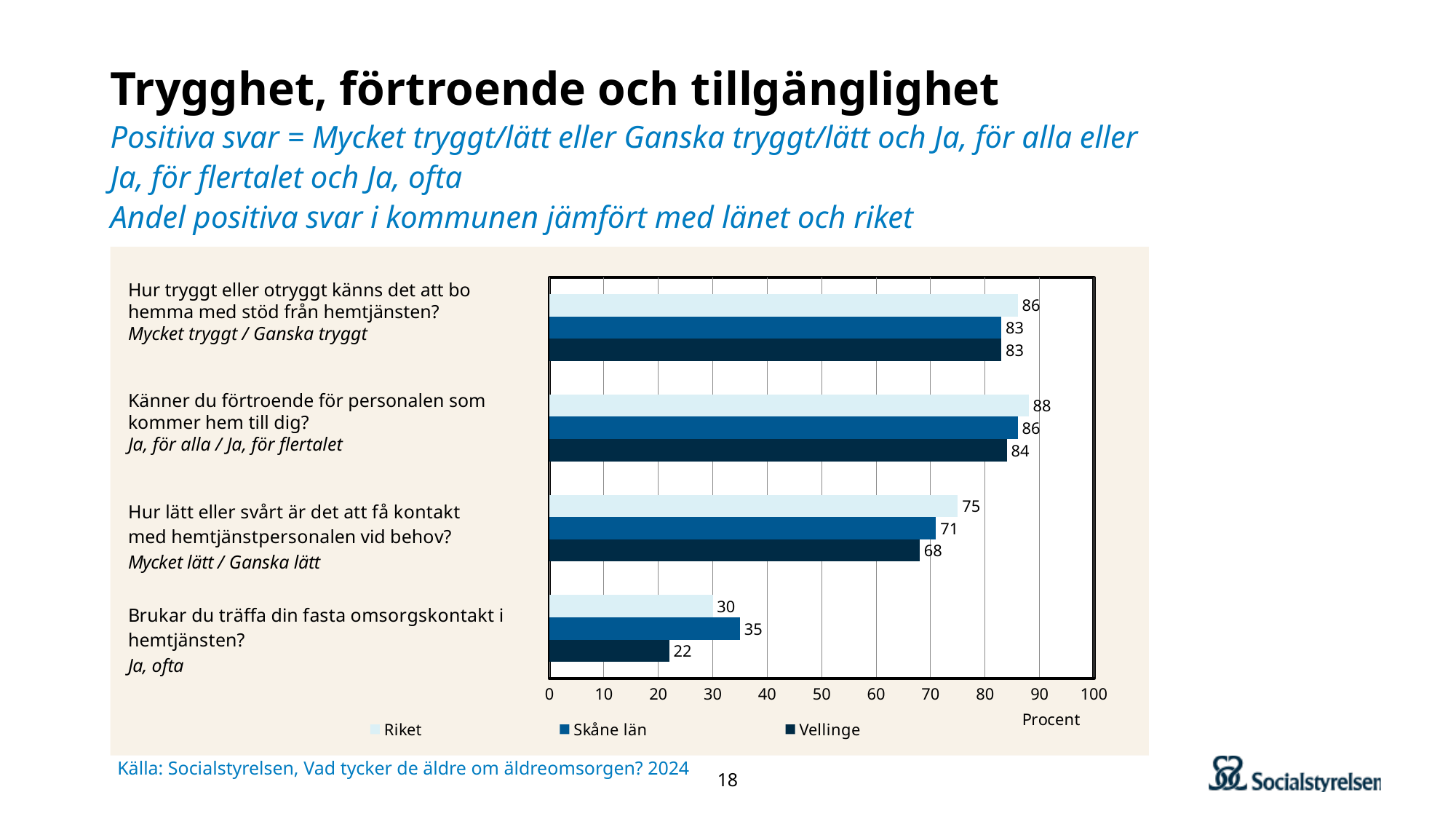
What is the difference between Riket and Vellinge on the question "Hur lätt eller svårt är det att få kontakt med hemtjänstpersonalen vid behov?"? 7 Which series has the highest value on the question "Brukar du träffa din fasta omsorgskontakt i hemtjänsten?"? Skåne län How many series does the legend list? 3 What is the value for Skåne län on the question "Hur lätt eller svårt är det att få kontakt med hemtjänstpersonalen vid behov?"? 71 How many questions (categories) are shown in the chart? 4 What unit is shown on the x axis of the chart? Procent What is the value for Riket on the question "Känner du förtroende för personalen som kommer hem till dig?"? 88 What kind of chart is shown on the slide? Bar chart What is the value for Vellinge on the question "Brukar du träffa din fasta omsorgskontakt i hemtjänsten?"? 22 What is the value for Vellinge on the question "Hur tryggt eller otryggt känns det att bo hemma med stöd från hemtjänsten?"? 83 Which question has the lowest value for Vellinge? Brukar du träffa din fasta omsorgskontakt i hemtjänsten? Which is larger on the question "Känner du förtroende för personalen som kommer hem till dig?": Skåne län or Vellinge? Skåne län